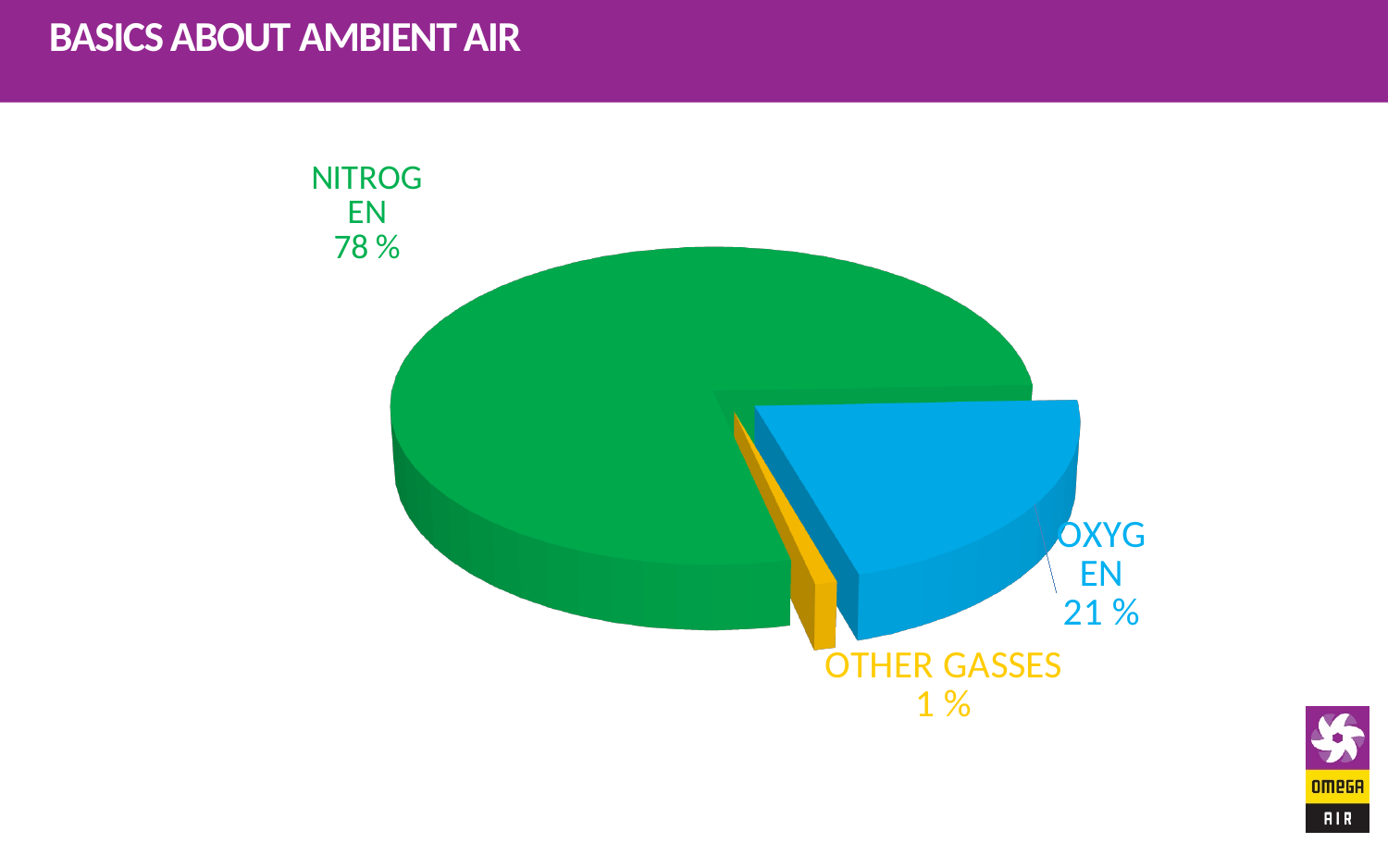
How many slices does the pie chart have? 3 What share of ambient air is other gasses according to the chart? 1 % What share of ambient air is nitrogen according to the chart? 78 % What is the difference in percentage points between the nitrogen and oxygen slices? 57 Which slice of the pie is the smallest? Other gasses What colour is the nitrogen slice? green What is the difference in percentage points between the oxygen and other gasses slices? 20 Which is larger, the oxygen slice or the other gasses slice? Oxygen What kind of chart is shown on the slide? pie chart What colour is the oxygen slice? blue Which slice of the pie is the largest? Nitrogen What share of ambient air is oxygen according to the chart? 21 %